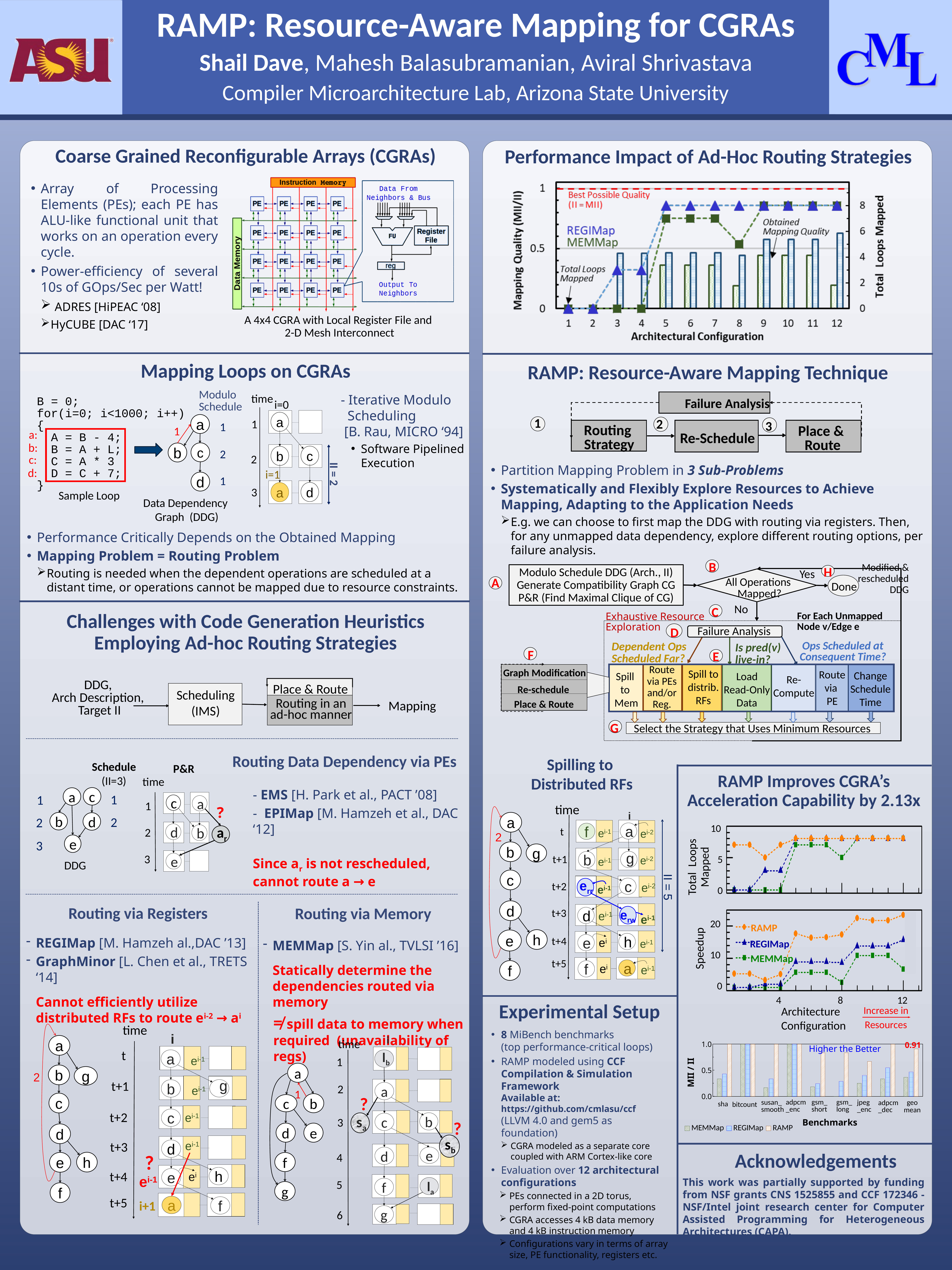
In the MII/II bar chart at the bottom right, is the MEMMap value for sha greater or less than 0.5? less In the Speedup chart under 'RAMP Improves CGRA's Acceleration Capability by 2.13x', is the MEMMap speedup at architecture configuration 12 greater or less than 10? less In the MII/II bar chart at the bottom right, what is the RAMP value for geo mean? 0.91 In the 'Performance Impact of Ad-Hoc Routing Strategies' chart, is the mapping quality of MEMMap at configuration 5 greater or less than 0.5? greater In the MII/II bar chart at the bottom right, how many series does the legend list? 3 In the Speedup chart under 'RAMP Improves CGRA's Acceleration Capability by 2.13x', which series has the highest speedup at architecture configuration 12? RAMP In the MII/II bar chart at the bottom right, how many benchmark categories (including geo mean) are on the x axis? 9 In the 'Performance Impact of Ad-Hoc Routing Strategies' chart, which two mapping techniques are plotted as lines? REGIMap and MEMMap In the 'Performance Impact of Ad-Hoc Routing Strategies' chart, what is the mapping quality of REGIMap at architectural configuration 1? 0 In the 'Performance Impact of Ad-Hoc Routing Strategies' chart, how many architectural configurations are shown on the x axis? 12 In the 'Performance Impact of Ad-Hoc Routing Strategies' chart, what value does the dashed red 'Best Possible Quality' line sit at? 1